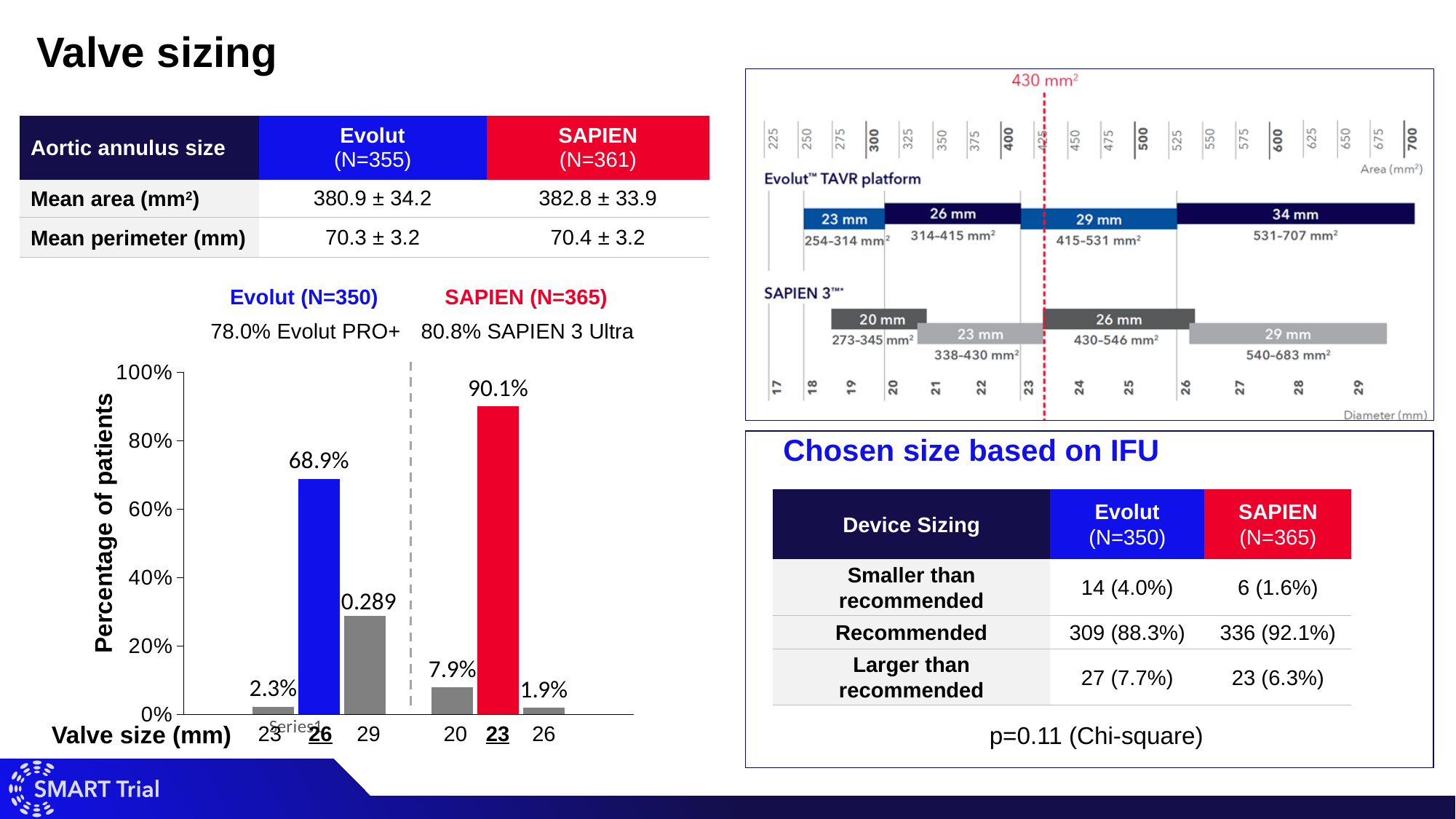
How many bars are plotted in the valve size bar chart? 6 In the bar chart, which is larger: the Evolut 26 mm bar or the SAPIEN 23 mm bar? SAPIEN 23 mm In the bar chart, what percentage of SAPIEN patients received the 23 mm valve? 90.1% In the bar chart, is the value for the Evolut 29 mm valve greater or less than 40%? less In the bar chart, what percentage of Evolut patients received the 26 mm valve? 68.9% What is the label on the vertical axis of the valve size chart? Percentage of patients In the bar chart, what is the data label printed on the Evolut 29 mm bar? 0.289 In the bar chart, what is the data label on the SAPIEN 26 mm bar? 1.9% In the bar chart, what is the difference between the SAPIEN 23 mm value and the Evolut 26 mm value? 21.2 percentage points In the bar chart, which valve size has the tallest bar? SAPIEN 23 mm In the bar chart, what is the data label on the Evolut 23 mm bar? 2.3% In the bar chart, what is the data label on the SAPIEN 20 mm bar? 7.9%